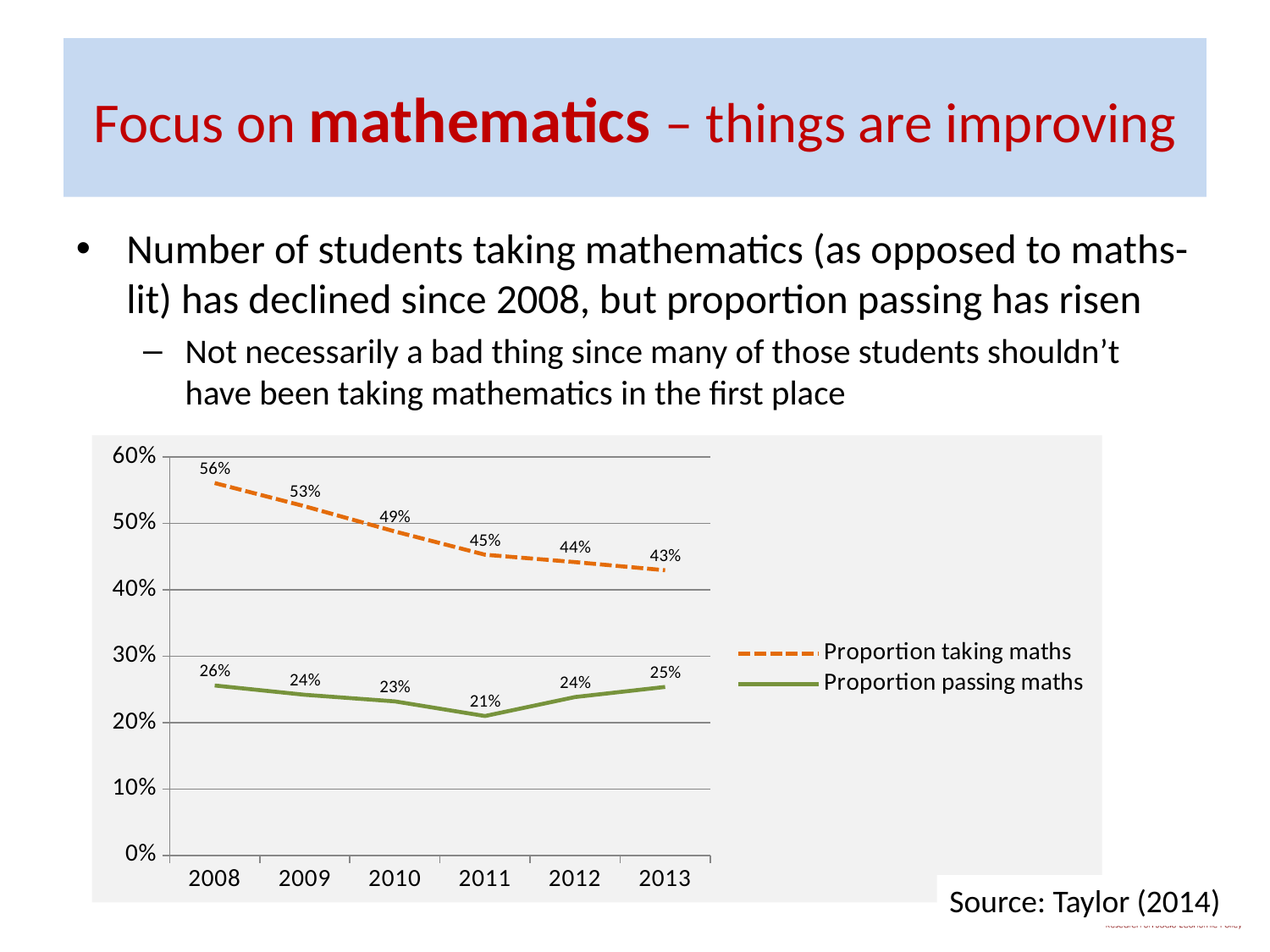
What is the proportion passing maths in 2011? 21% What is the difference between the proportion taking maths in 2008 and in 2013? 13% How many series does the legend list? 2 Does the proportion taking maths rise or fall from 2008 to 2013? Fall How many years are shown on the x axis? 6 What is the proportion taking maths in 2008? 56% Which is larger in 2012: the proportion taking maths or the proportion passing maths? Proportion taking maths What kind of chart is shown on the slide? Line chart What is the proportion taking maths in 2013? 43% Is the proportion taking maths in 2010 greater or less than 40%? greater In which year is the proportion taking maths highest? 2008 In which year is the proportion passing maths lowest? 2011